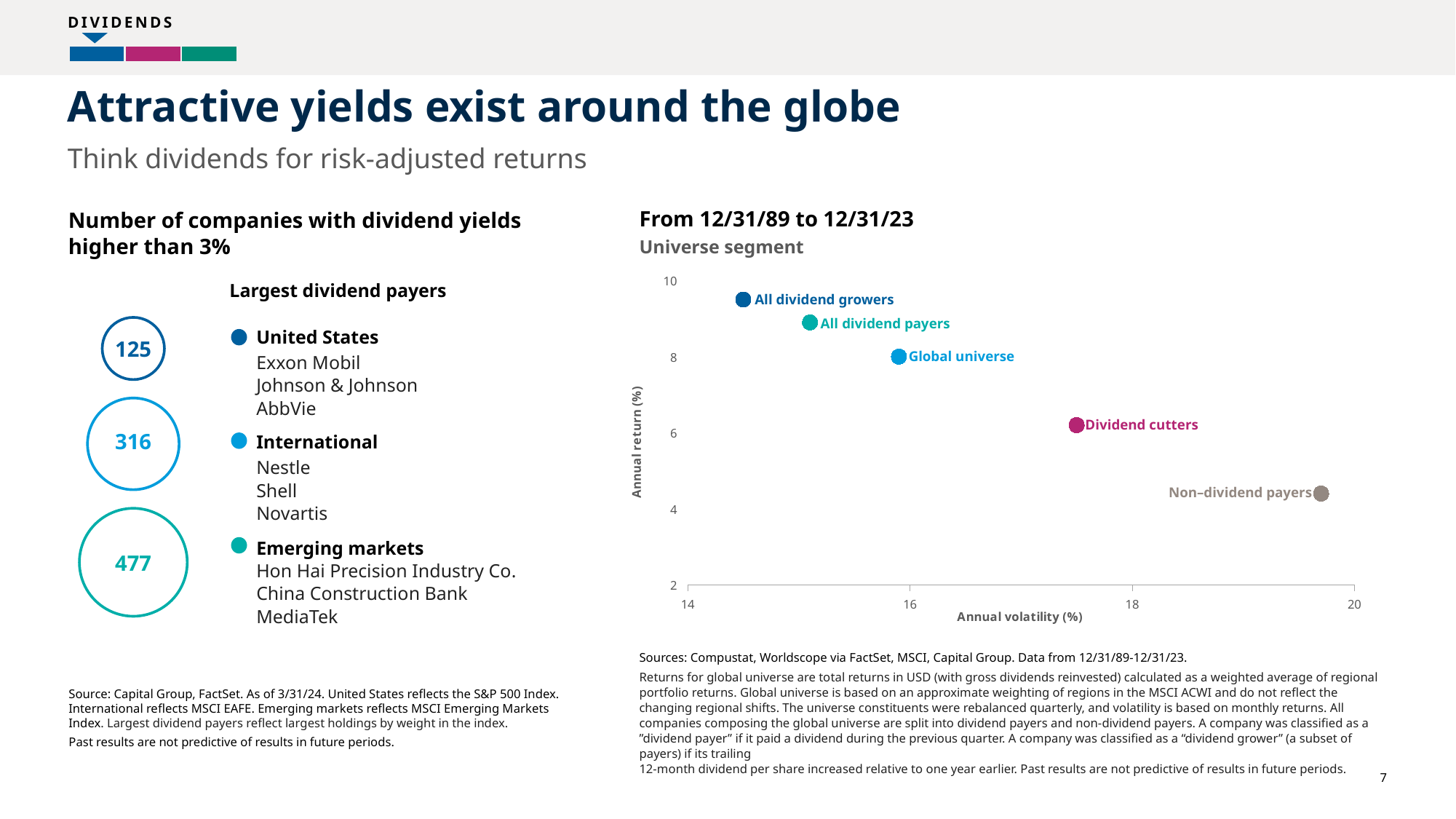
How many data points are plotted on the 'Universe segment' scatter chart? 5 On the 'Universe segment' chart, do annual returns generally rise or fall as annual volatility increases? fall On the 'Universe segment' chart, is the annual return for All dividend growers greater or less than 8? greater On the 'Universe segment' chart, which segment has the highest annual return? All dividend growers On the 'Universe segment' chart, which segment has the lowest annual return? Non-dividend payers On the 'Universe segment' chart, is the annual volatility for Dividend cutters greater or less than 18? less On the 'Universe segment' chart, what is the title of the horizontal axis? Annual volatility (%) On the 'Universe segment' chart, is the annual return for Non-dividend payers greater or less than 6? less On the 'Universe segment' chart, which has the higher annual return: Global universe or Dividend cutters? Global universe On the 'Universe segment' chart, which segment has the lowest annual volatility? All dividend growers On the 'Universe segment' chart, which segment has the highest annual volatility? Non-dividend payers What kind of chart is the 'Universe segment' chart on the right of the slide? scatter chart